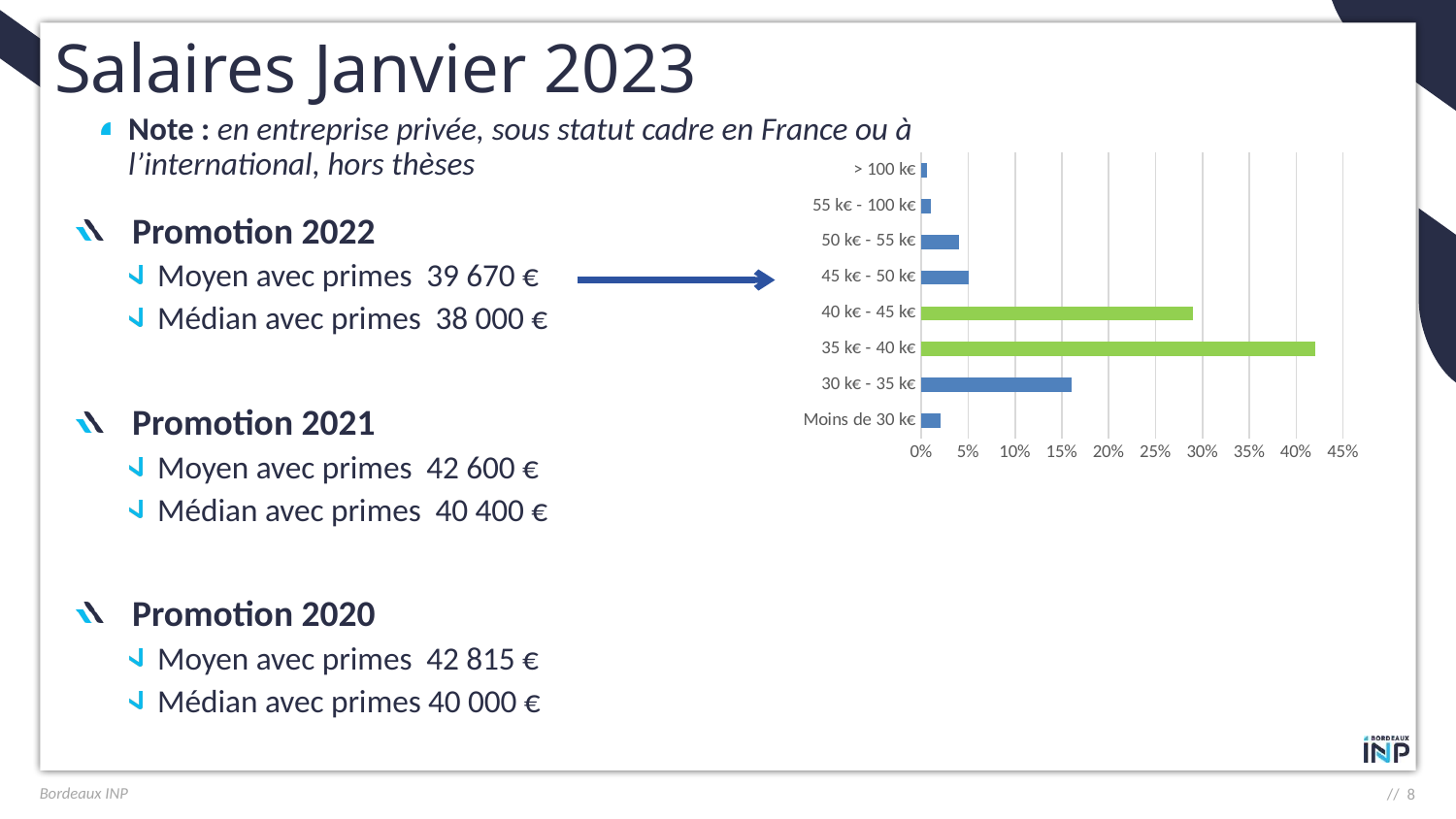
Which is larger, the value for 50 k€ - 55 k€ or the value for Moins de 30 k€? 50 k€ - 55 k€ Is the value for 40 k€ - 45 k€ greater or less than 25%? greater What is the highest value shown on the chart's percentage axis? 45% Is the value for 30 k€ - 35 k€ greater or less than 20%? less Which salary category has the highest share? 35 k€ - 40 k€ Which is larger, the value for 40 k€ - 45 k€ or the value for 30 k€ - 35 k€? 40 k€ - 45 k€ What kind of chart is shown on the slide? bar chart Is the value for 45 k€ - 50 k€ greater or less than 10%? less Which is larger, the value for 35 k€ - 40 k€ or the value for 40 k€ - 45 k€? 35 k€ - 40 k€ How many salary categories does the chart show? 8 Which two bars on the chart are coloured green? 40 k€ - 45 k€ and 35 k€ - 40 k€